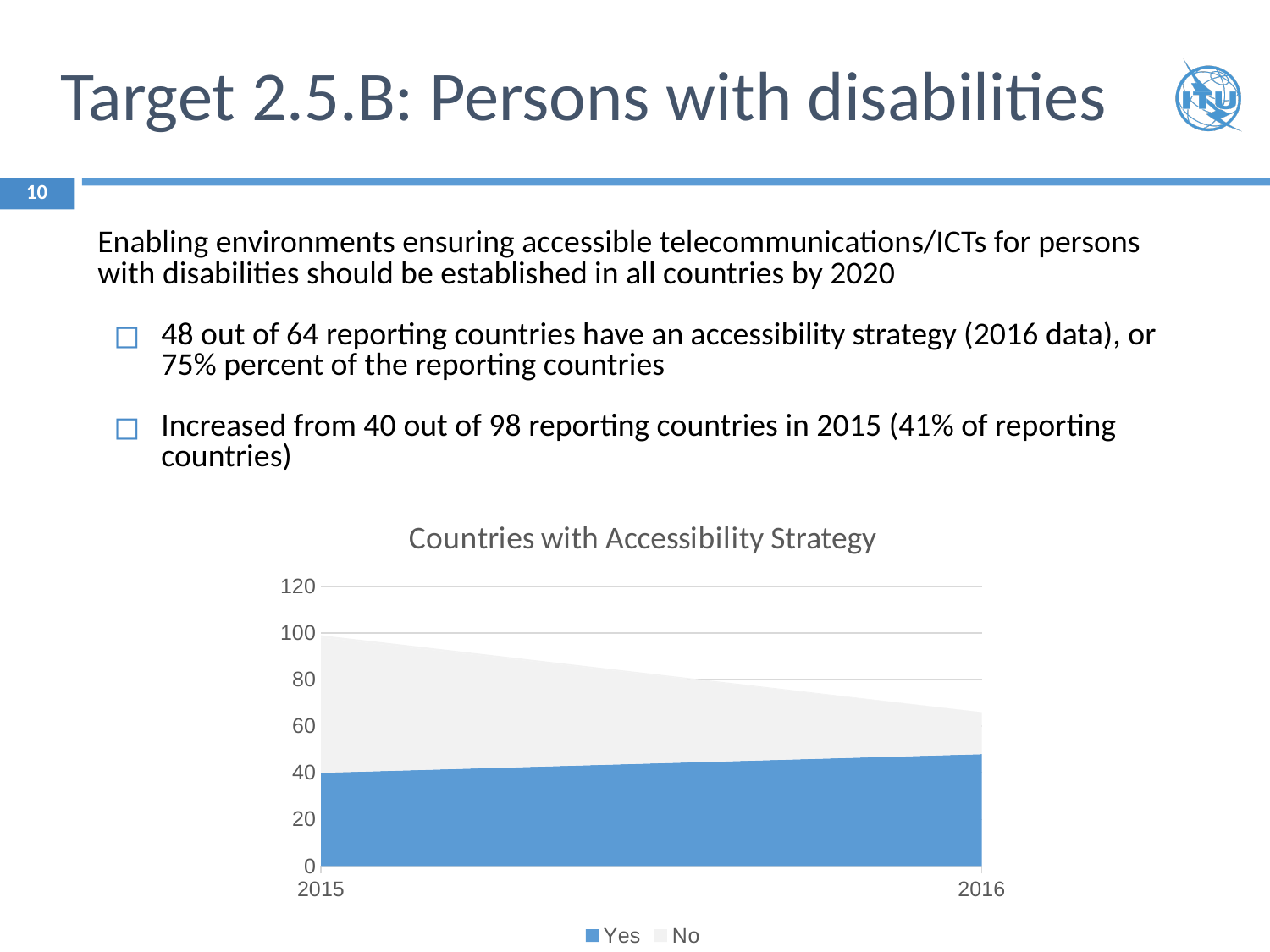
Is the stacked total of "Yes" and "No" in 2016 greater or less than 80? less What kind of chart is shown on the slide? area chart Is the value for "Yes" in 2016 greater or less than 60? less How many years are shown on the x axis of the chart? 2 How many series does the chart legend list? 2 Which colour represents the "Yes" series in the chart? blue In 2016, which is larger, the "Yes" value or the "No" value? Yes What is the title of the chart? Countries with Accessibility Strategy Does the "No" series rise or fall from 2015 to 2016? fall Is the value for "Yes" in 2016 greater or less than 40? greater Does the "Yes" series rise or fall from 2015 to 2016? rise